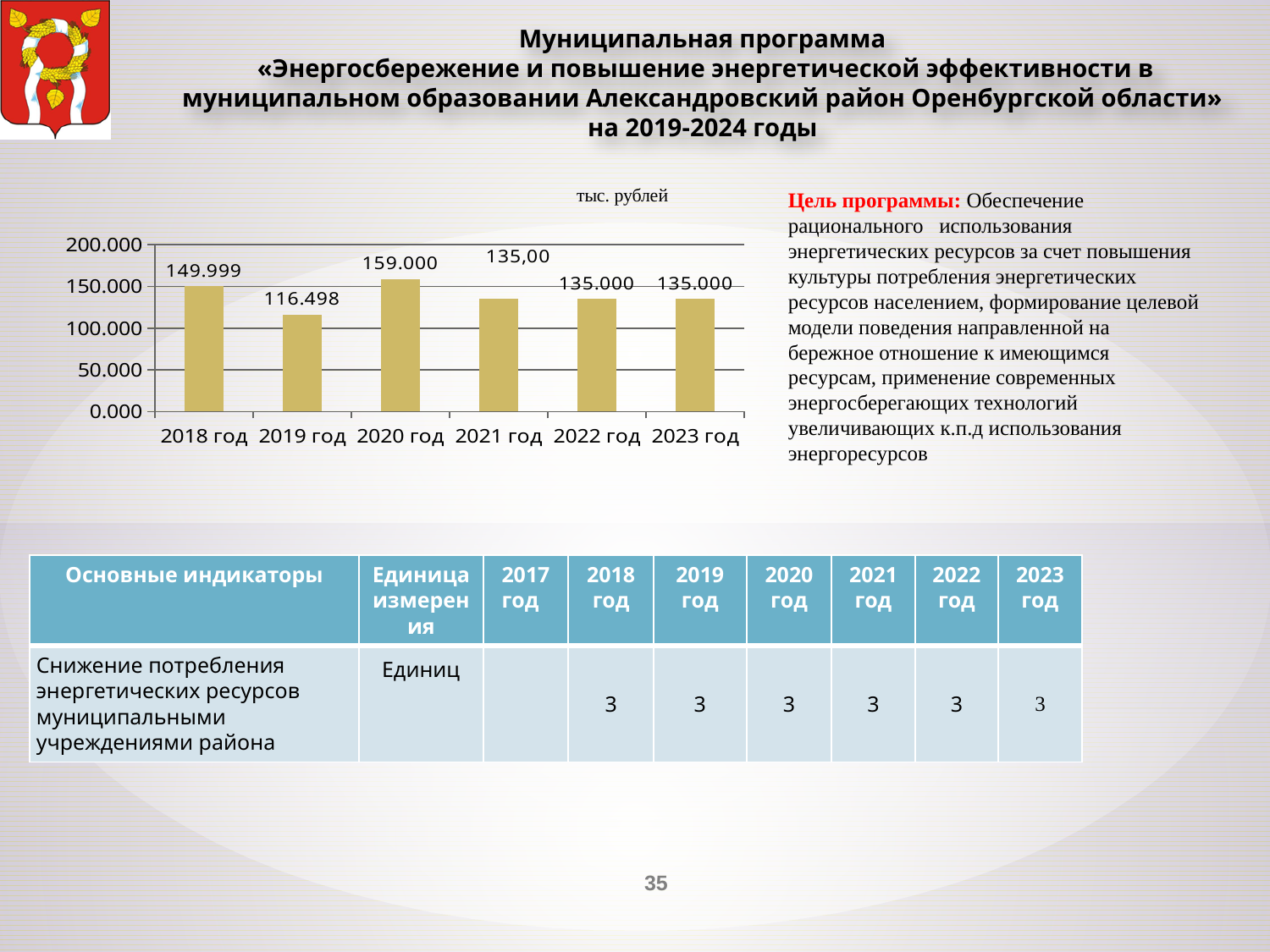
Is the value for 2019 год greater or less than 150.000? less What type of chart is shown on the slide? bar chart What is the value for 2019 год in the chart? 116.498 What is the value for 2022 год in the chart? 135.000 What is the value for 2018 год in the chart? 149.999 Which year has the highest value in the chart? 2020 год What unit is indicated above the chart? тыс. рублей How many bars (years) are plotted in the chart? 6 Which year has the lowest value in the chart? 2019 год Which is larger in the chart, the value for 2018 год or the value for 2019 год? 2018 год What is the difference between the values for 2020 год and 2022 год in the chart? 24.000 What is the value for 2020 год in the chart? 159.000